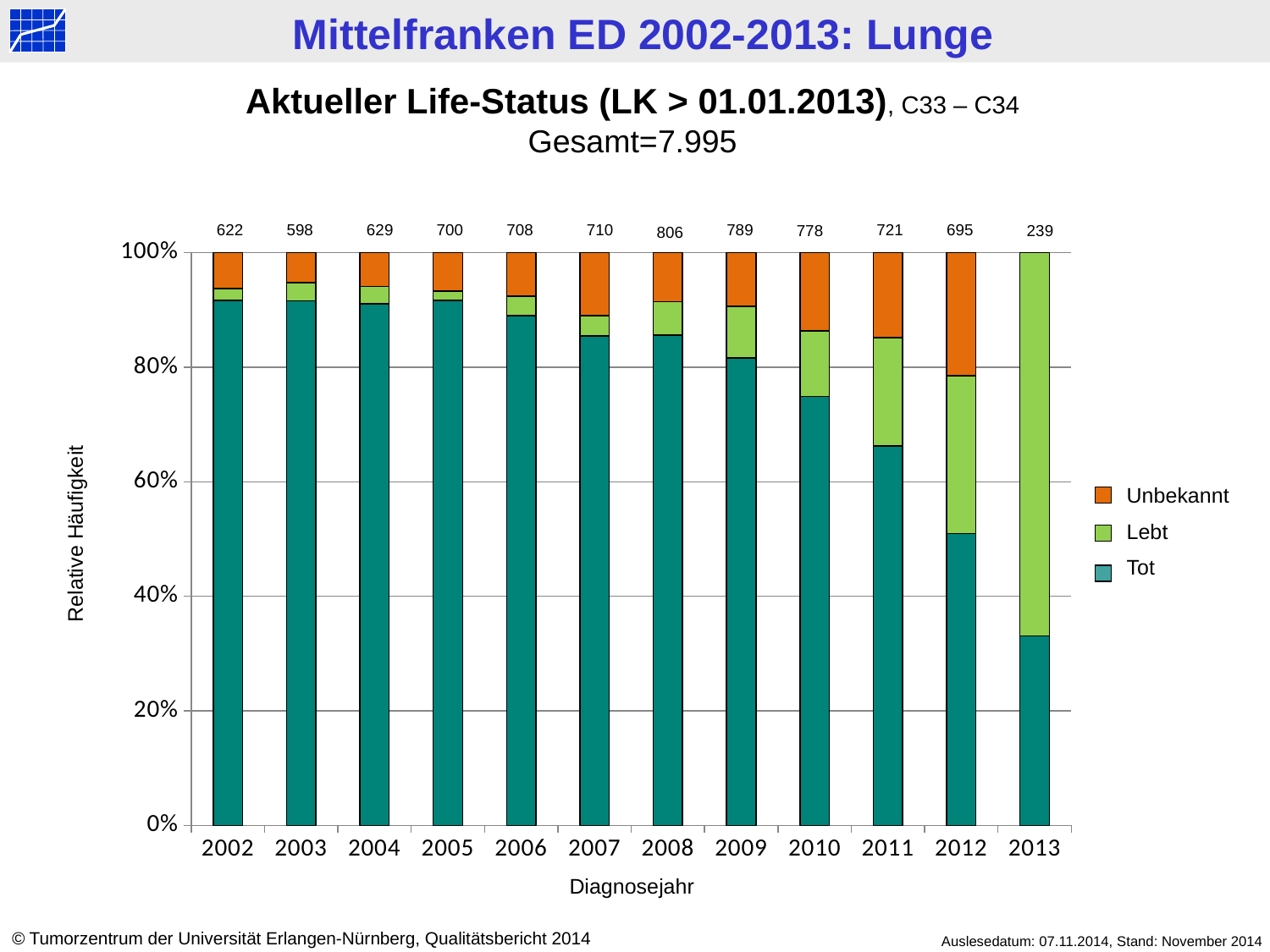
Which diagnosis year has the highest number printed above its bar? 2008 Is the share of 'Tot' in 2002 greater or less than 80%? greater What is the number printed above the bar for 2008? 806 What is the number printed above the bar for 2002? 622 Which has the larger number printed above its bar, 2009 or 2010? 2009 Is the share of 'Tot' in 2013 greater or less than 40%? less How many diagnosis years are shown on the x axis? 12 What is the number printed above the bar for 2013? 239 Which diagnosis year has the lowest number printed above its bar? 2013 Does the share of 'Tot' rise or fall from 2002 to 2013? fall How many series does the legend list? 3 What is the difference between the numbers printed above the bars for 2008 and 2013? 567